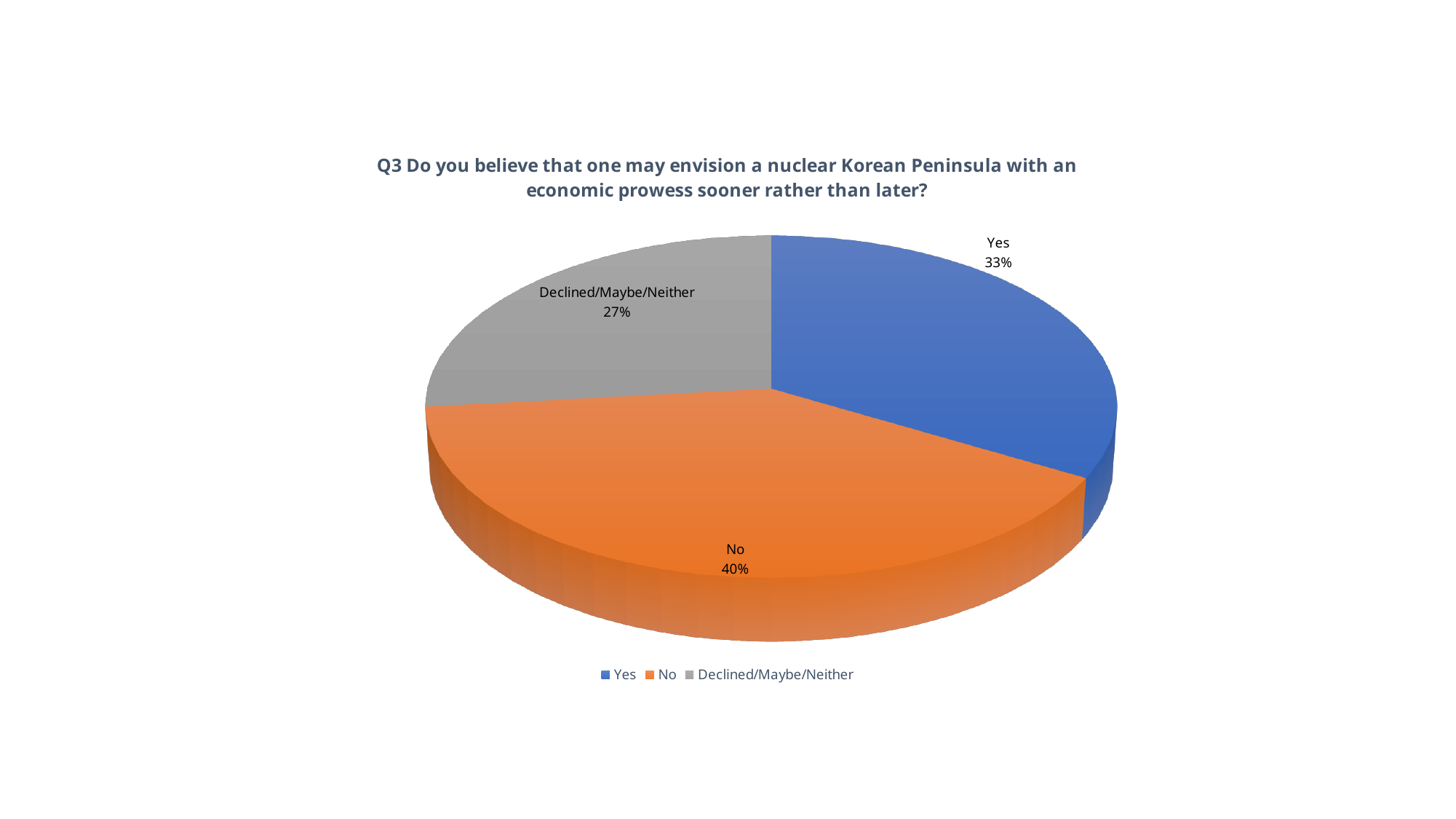
What kind of chart is shown on the slide? pie chart What percentage of respondents answered "Yes"? 33% Which response has the smallest share of the pie? Declined/Maybe/Neither What is the difference in percentage points between "Yes" and "Declined/Maybe/Neither"? 6 Which response has the largest share of the pie? No How many entries does the legend list? 3 How many slices does the pie chart have? 3 What percentage of respondents answered "No"? 40% What percentage is shown for "Declined/Maybe/Neither"? 27% Which is larger, the share for "Yes" or the share for "Declined/Maybe/Neither"? Yes What is the difference in percentage points between "No" and "Yes"? 7 What colour is the "No" slice? orange